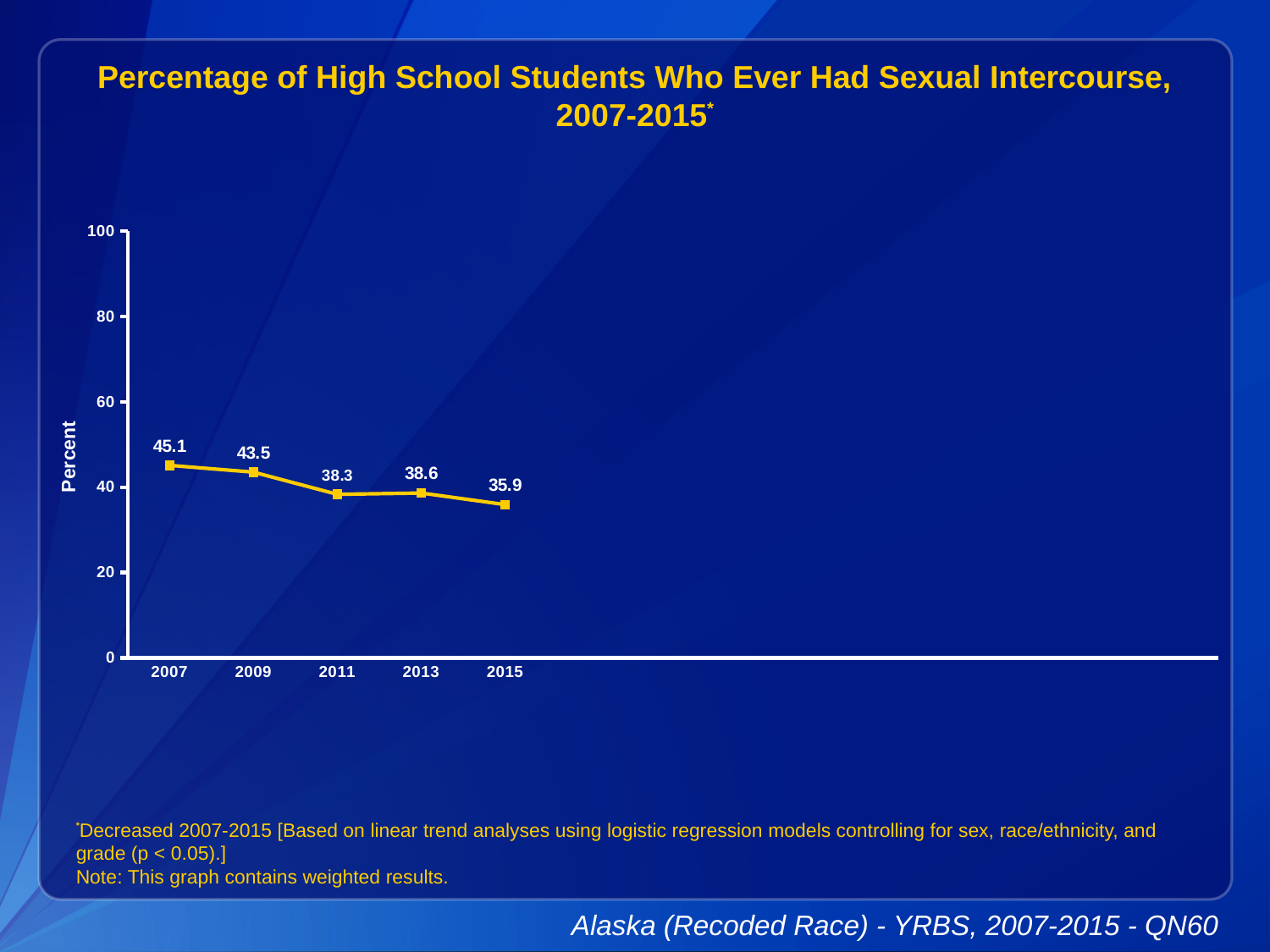
What is the label on the y axis? Percent What kind of chart is shown? line chart Which year has the lowest percentage? 2015 Which year has the highest percentage? 2007 How many years are plotted on the chart? 5 What value is shown for 2011? 38.3 What value is shown for 2015? 35.9 Do the values generally rise or fall from 2007 to 2015? fall What is the difference between the 2007 value and the 2015 value? 9.2 Is the value for 2015 greater or less than 40? less What was the percentage of high school students who ever had sexual intercourse in 2007? 45.1 Which is larger, the value for 2009 or the value for 2013? 2009